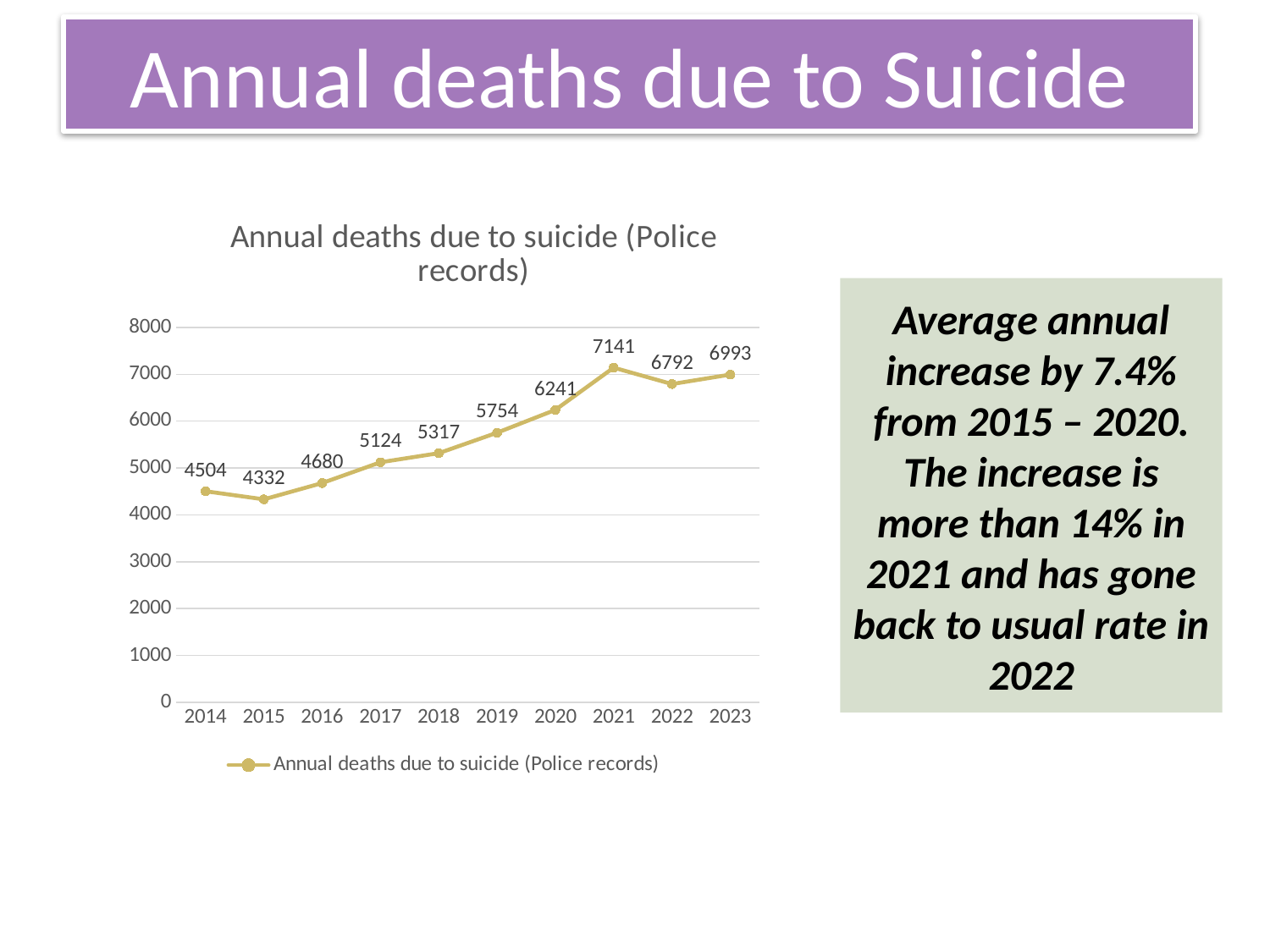
What is the value for 2014? 4504 What is the difference between the values for 2020 and 2019? 487 Which year has the lowest value? 2015 What is the value for 2023? 6993 How many years are plotted on the chart? 10 What is the value for 2021? 7141 Which is larger, the value for 2022 or the value for 2023? 2023 Do the values generally rise or fall from 2015 to 2021? rise What kind of chart is shown? line chart Which year has the highest value? 2021 Is the value for 2018 greater or less than 5000? greater What is the difference between the values for 2021 and 2022? 349